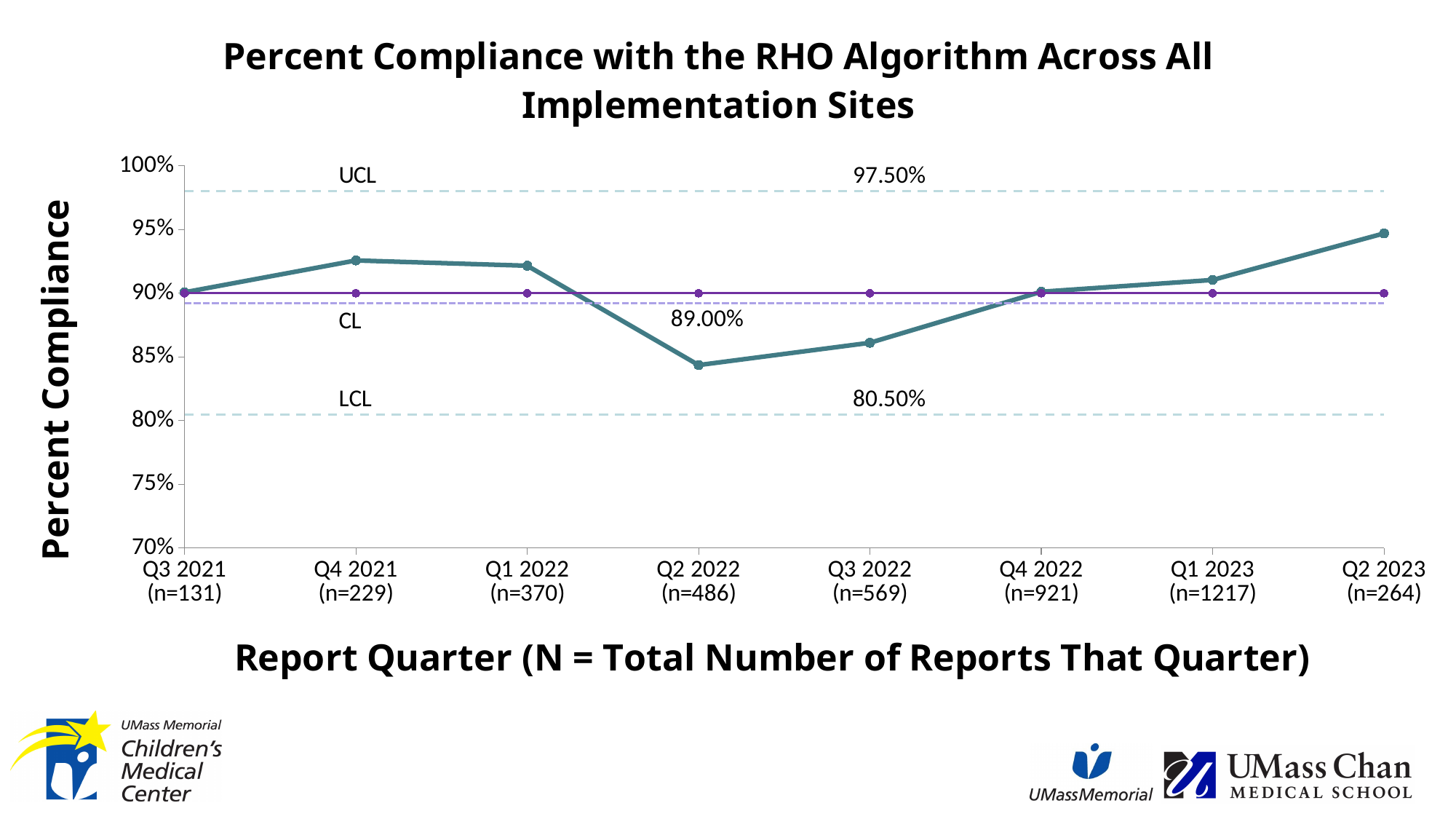
How many report quarters are plotted on the x axis? 8 Which report quarter has the highest percent compliance? Q2 2023 What is the total number of reports (n) for Q1 2023? n=1217 Does percent compliance rise or fall from Q2 2022 to Q2 2023? rise Which has higher percent compliance, Q3 2021 or Q4 2021? Q4 2021 Which report quarter has the lowest percent compliance? Q2 2022 What value is labelled for the CL line? 89.00% Is the percent compliance for Q4 2021 greater or less than 90%? greater What kind of chart is shown on the slide? line chart What is the value of the UCL line? 97.50% Is the percent compliance for Q2 2022 greater or less than 85%? less What is the value of the LCL line? 80.50%